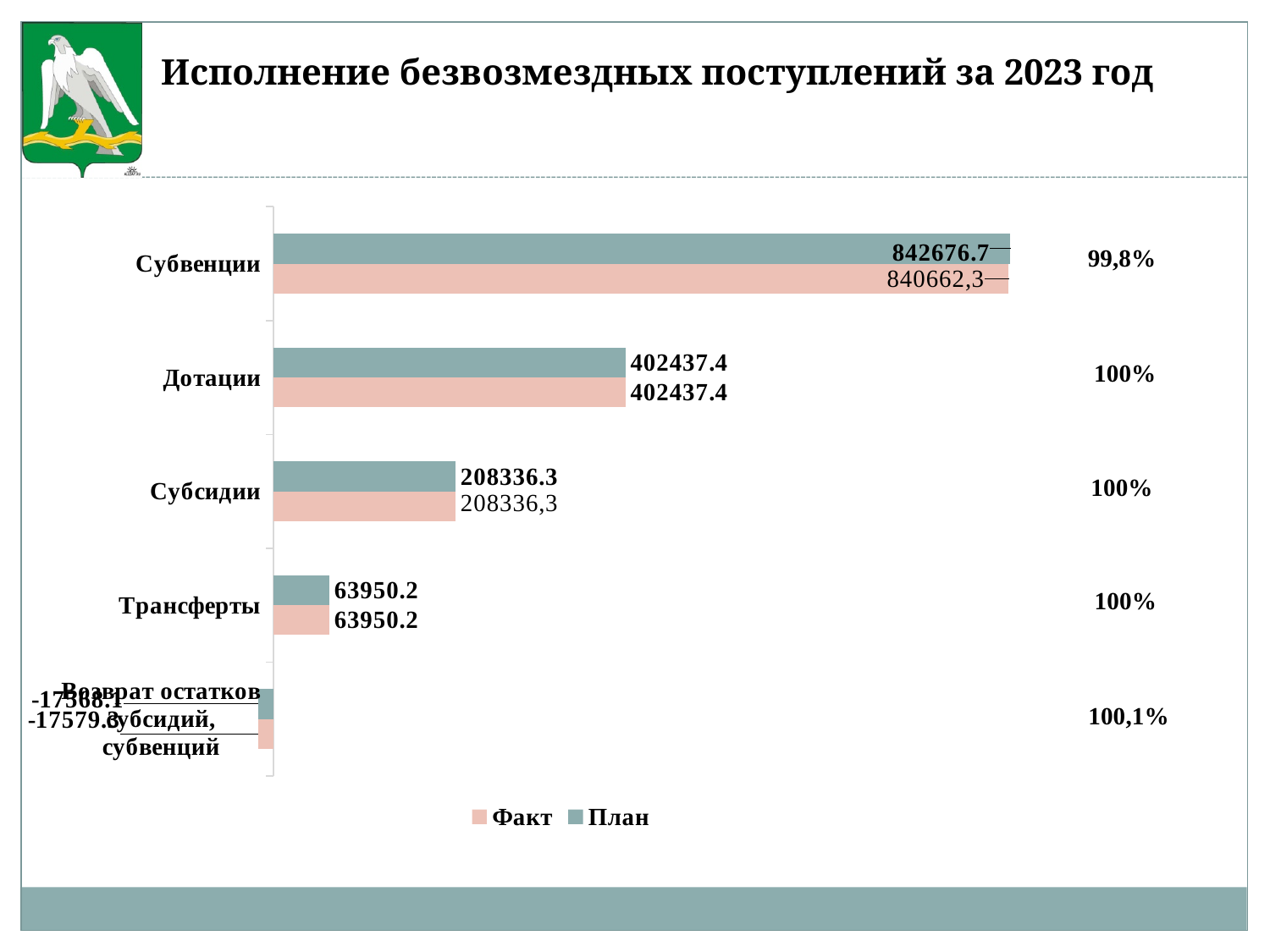
How many series does the legend list? 2 What is the Факт value for Трансферты? 63950.2 Which category has the highest План value? Субвенции What is the План value for Субвенции? 842676.7 What is the difference between the План values for Дотации and Трансферты? 338487.2 What execution percentage is shown next to Субвенции? 99,8% What is the План value for Субсидии? 208336.3 What kind of chart is shown on the slide? bar chart What is the План value for Дотации? 402437.4 What are the two series named in the legend? Факт and План Which is larger, the План value for Дотации or the План value for Субсидии? Дотации What is the Факт value for Субвенции? 840662,3